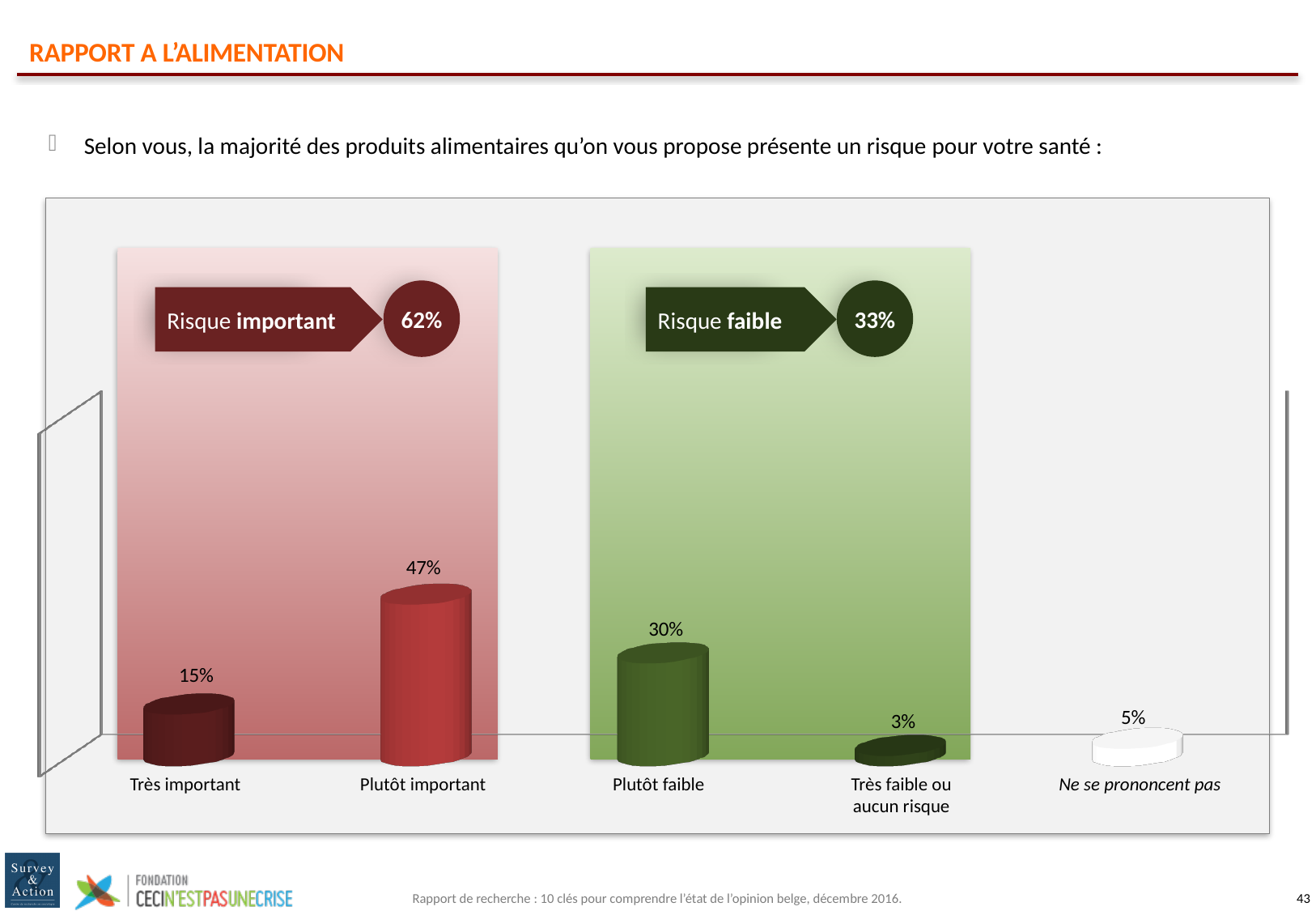
What is the value for "Plutôt important"? 47% What is the value for "Très faible ou aucun risque"? 3% What kind of chart is this? bar chart What is the value for "Ne se prononcent pas"? 5% How many categories are shown on the chart? 5 Which category has the lowest value? Très faible ou aucun risque What percentage is shown in the "Risque important" callout? 62% Which is larger, the value for "Très important" or the value for "Plutôt faible"? Plutôt faible What is the value for "Très important"? 15% What is the value for "Plutôt faible"? 30% What is the difference between the values for "Plutôt important" and "Plutôt faible"? 17% Which category has the highest value? Plutôt important